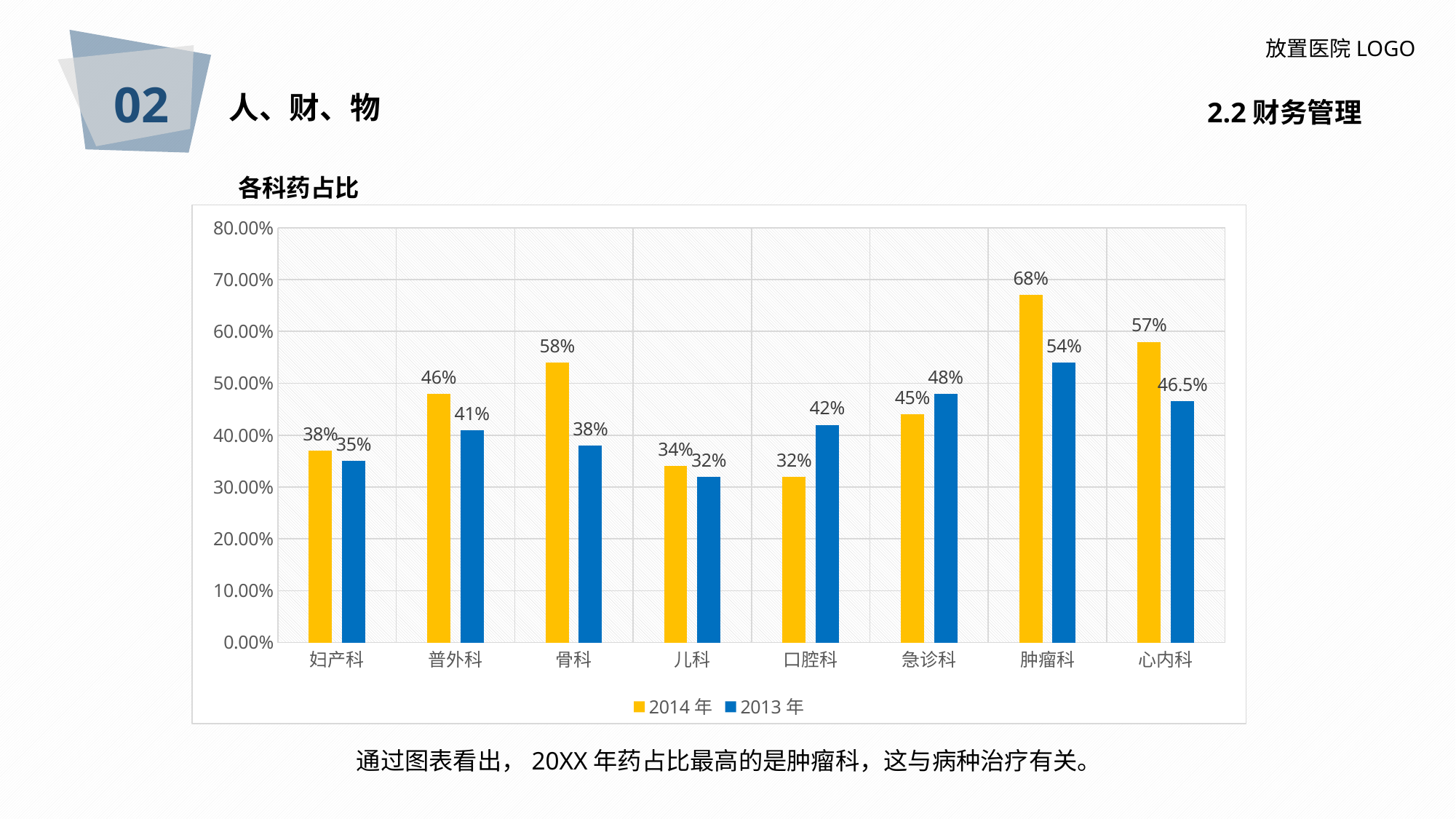
What is the 2013 年 value for 口腔科? 42% What is the title of the chart? 各科药占比 Which department has the highest 2014 年 value? 肿瘤科 What is the 2014 年 value for 肿瘤科? 68% What kind of chart is shown on the slide? Bar chart What is the 2013 年 value for 心内科? 46.5% Which is larger for 急诊科, the 2014 年 value or the 2013 年 value? 2013 年 How many departments are shown on the x axis? 8 Which department has the lowest 2014 年 value? 口腔科 What is the difference between the 2014 年 and 2013 年 values for 骨科? 20% How many series does the legend list? 2 Which department has the lowest 2013 年 value? 儿科